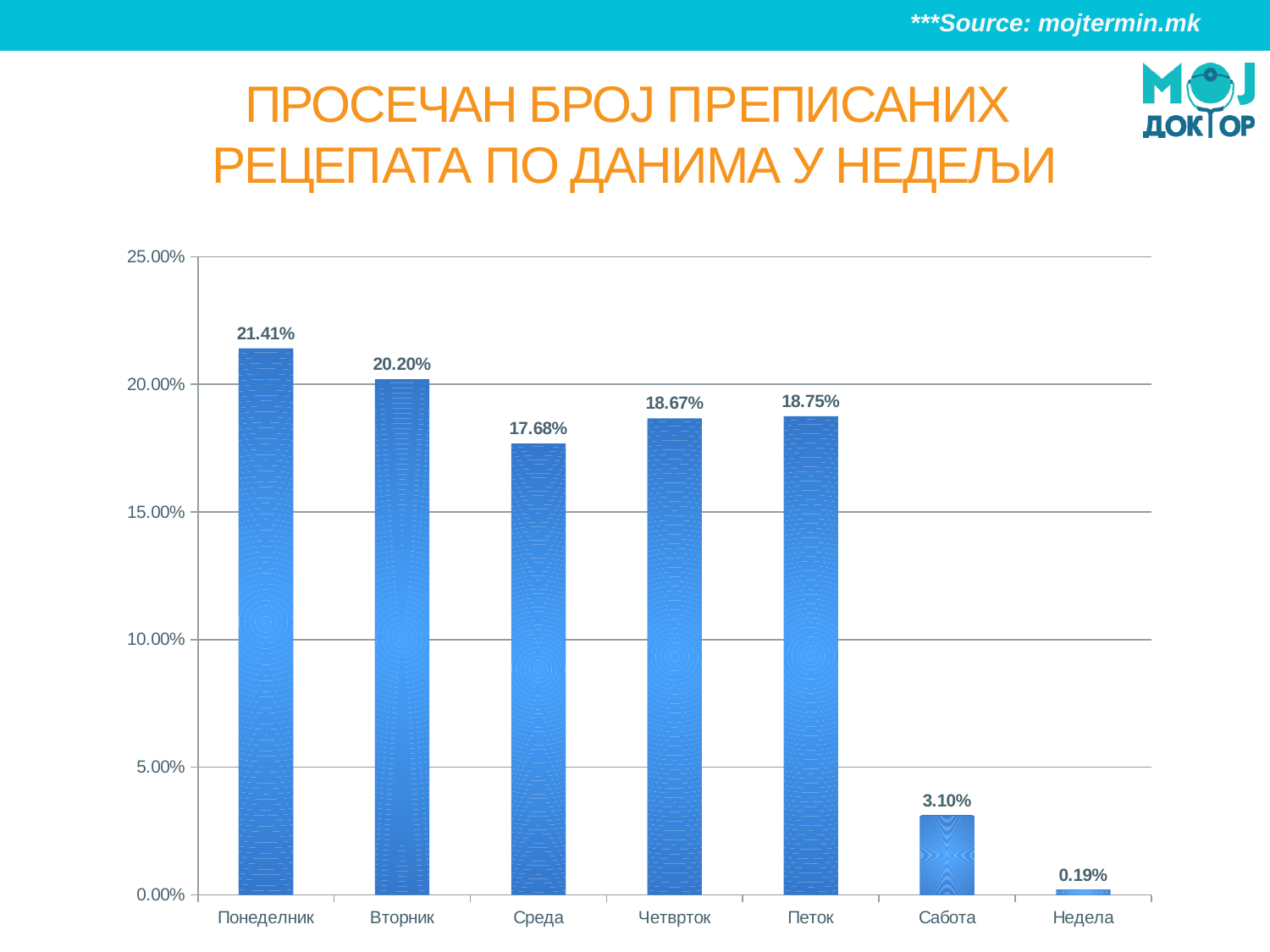
What is the difference between the values for Понеделник and Вторник? 1.21% Which day has the highest value? Понеделник Is the value for Четврток greater or less than 20.00%? less What is the value for Сабота? 3.10% What is the difference between the values for Сабота and Недела? 2.91% What kind of chart is shown on the slide? bar chart What is the highest value shown on the y axis? 25.00% How many days are shown on the x axis? 7 Which is larger, the value for Вторник or the value for Петок? Вторник Which day has the lowest value? Недела What is the value for Понеделник? 21.41% What is the value for Среда? 17.68%